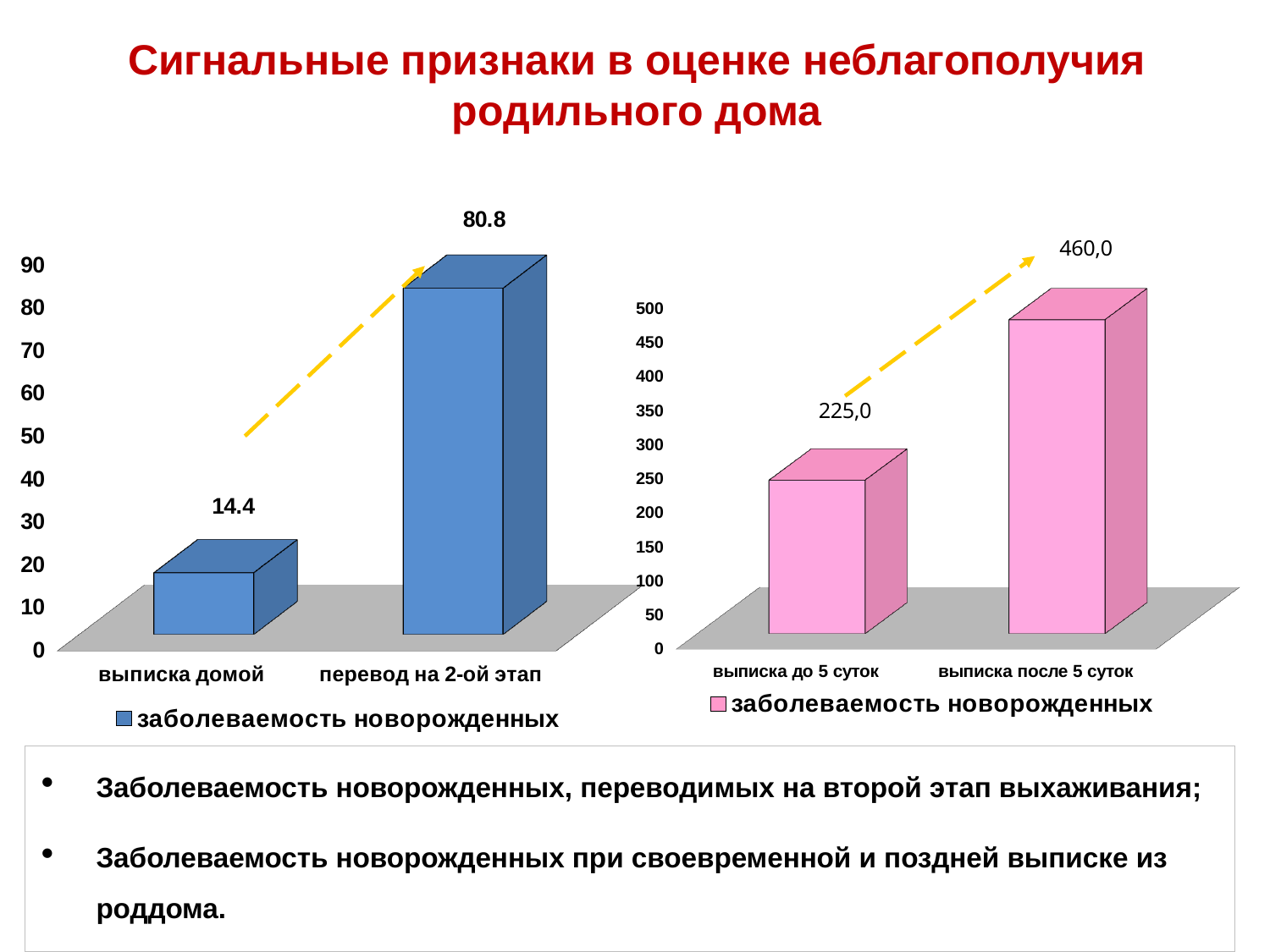
How many categories are shown in the left chart? 2 In the left chart, what is the value for 'перевод на 2-ой этап'? 80.8 In the right chart, which category has the lowest value? выписка до 5 суток In the right chart, which is larger: the value for 'выписка до 5 суток' or 'выписка после 5 суток'? выписка после 5 суток In the left chart, what is the value for 'выписка домой'? 14.4 In the right chart, what is the value for 'выписка до 5 суток'? 225,0 In the right chart, what is the difference between the values for 'выписка после 5 суток' and 'выписка до 5 суток'? 235,0 In the left chart, what is the difference between the values for 'перевод на 2-ой этап' and 'выписка домой'? 66.4 In the left chart, which category has the highest value? перевод на 2-ой этап What is the legend entry of the left chart? заболеваемость новорожденных In the right chart, what is the value for 'выписка после 5 суток'? 460,0 What kind of chart is the right chart? bar chart